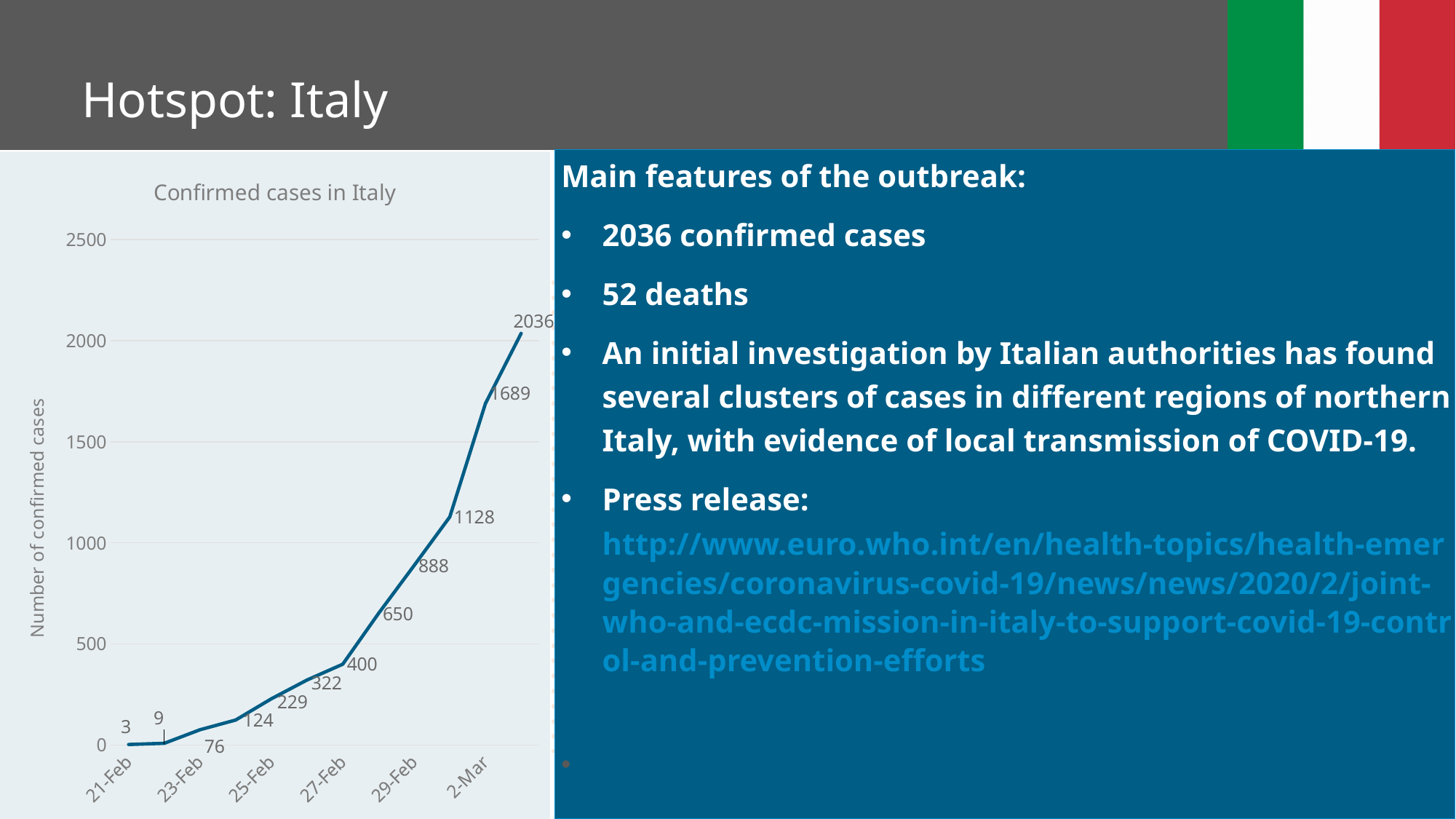
What is the number of confirmed cases on 21-Feb, the first point on the chart? 3 What is the title of the chart? Confirmed cases in Italy How many data points are plotted on the line? 12 What is the value of the last data point on the chart? 2036 Is the value for 21-Feb greater or less than 500? less Do the confirmed cases rise or fall from left to right along the x axis? rise What kind of chart is shown on the slide? line chart What is the lowest number of confirmed cases shown on the chart? 3 What is the difference between the values labelled 1128 and 888? 240 What is the highest number of confirmed cases shown on the chart? 2036 What is the label of the vertical axis? Number of confirmed cases What is the difference between the highest value (2036) and the value labelled 1689? 347